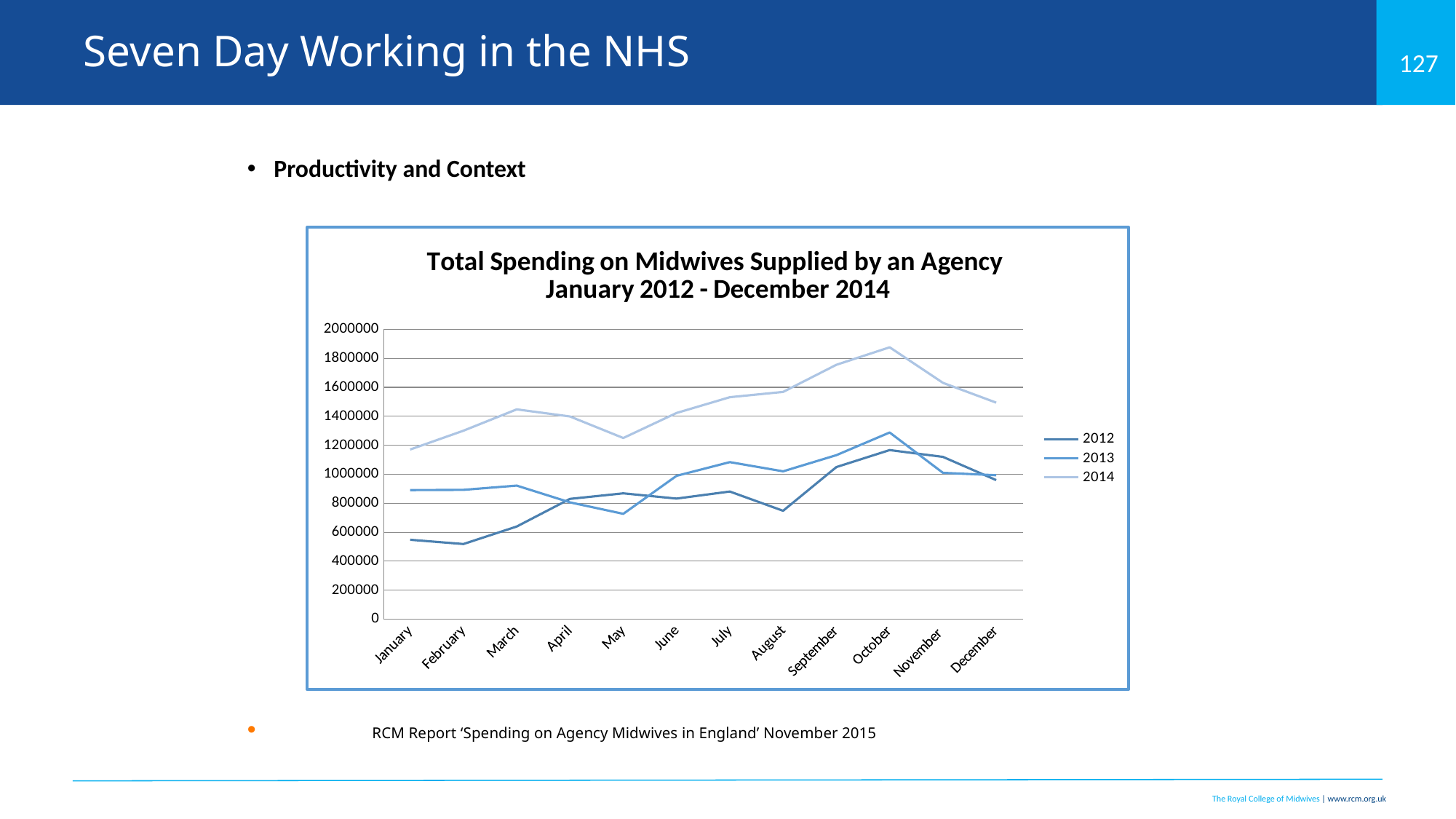
Is the value for 2013 in May greater or less than 800000? less In which month is the 2012 series at its lowest value? February What is the title of the chart? Total Spending on Midwives Supplied by an Agency January 2012 - December 2014 What kind of chart is shown on the slide? Line chart How many months are plotted along the x axis? 12 In which month is the 2014 series at its lowest value? January In July, which series has the larger value, 2012 or 2014? 2014 In which month does the 2014 series reach its highest value? October How many series does the legend list? 3 Is the value for 2014 in October greater or less than 1800000? greater Does the 2014 series rise or fall from January to March? Rise Is the value for 2012 in January greater or less than 600000? less